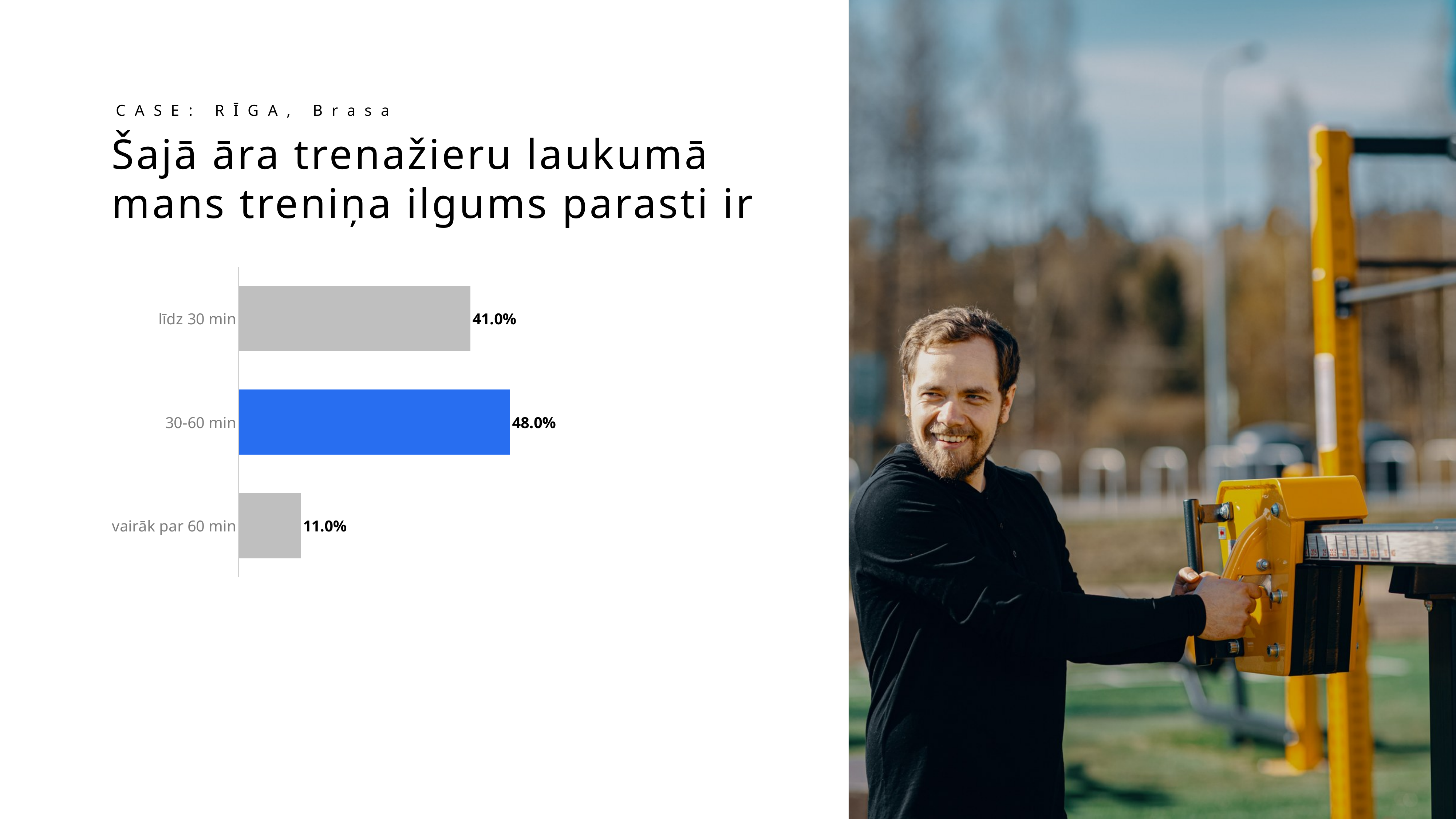
What is the value for "30-60 min"? 48.0% Which bar is coloured blue? 30-60 min How many categories does the chart show? 3 What kind of chart is shown on the slide? bar chart What is the difference between the values for "līdz 30 min" and "vairāk par 60 min"? 30.0% Which category has the lowest value? vairāk par 60 min What is the difference between the values for "30-60 min" and "līdz 30 min"? 7.0% What is the value for "līdz 30 min"? 41.0% Which is larger, the value for "līdz 30 min" or the value for "vairāk par 60 min"? līdz 30 min What is the value for "vairāk par 60 min"? 11.0% What is the total of all three values shown in the chart? 100.0% Which category has the highest value? 30-60 min